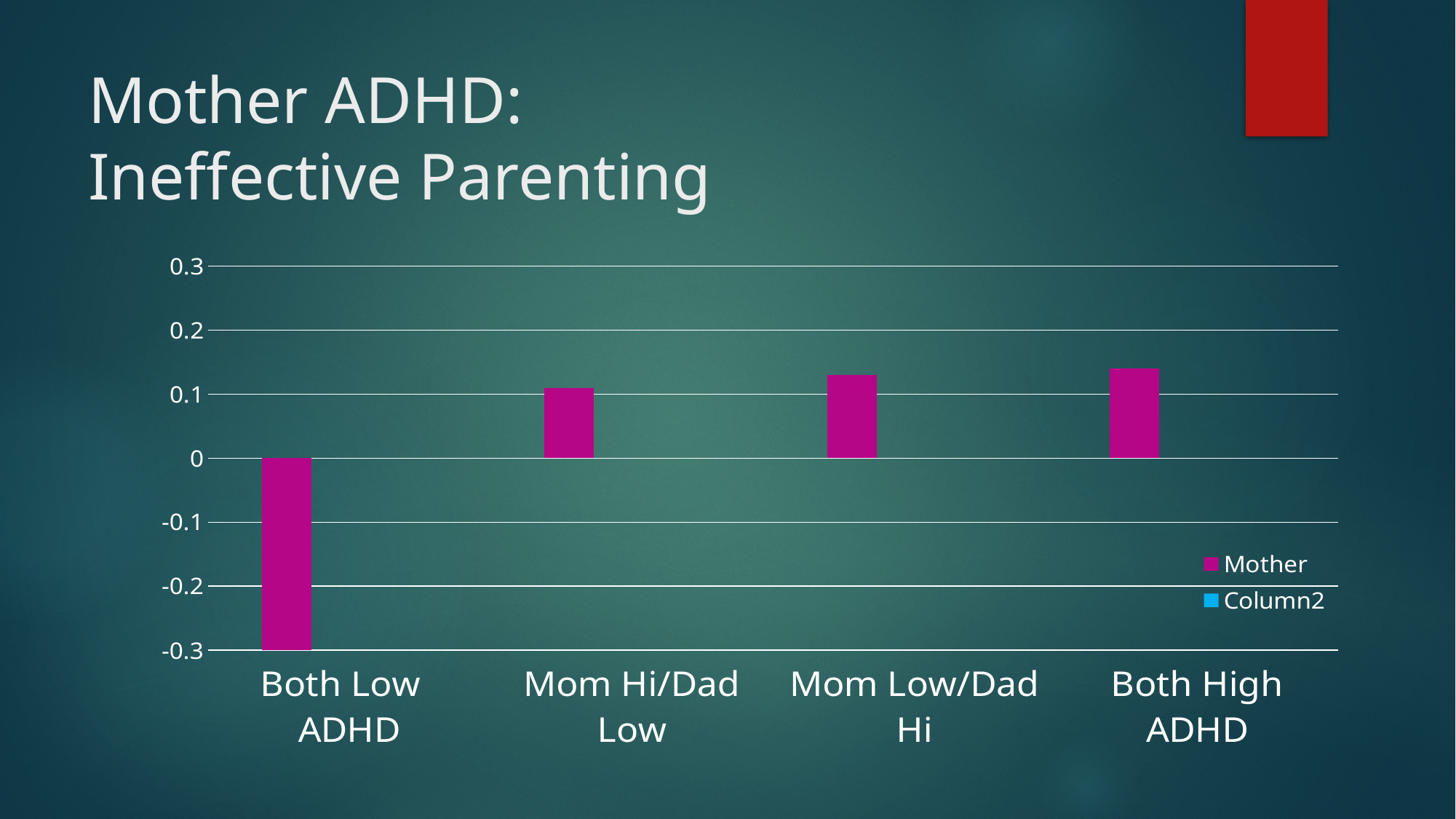
Which is larger, the value for Mom Hi/Dad Low or the value for Both High ADHD? Both High ADHD Is the value for Mom Low/Dad Hi greater or less than 0.1? greater What kind of chart is shown on the slide? bar chart What is the title of the slide containing the chart? Mother ADHD: Ineffective Parenting Which is larger, the value for Both Low ADHD or the value for Mom Hi/Dad Low? Mom Hi/Dad Low Which category has the lowest value in the chart? Both Low ADHD How many series does the chart's legend list? 2 What are the two entries listed in the chart's legend? Mother and Column2 Is the value for Mom Hi/Dad Low greater or less than 0.2? less Is the value for Both Low ADHD greater or less than -0.2? less How many categories are shown on the x axis of the chart? 4